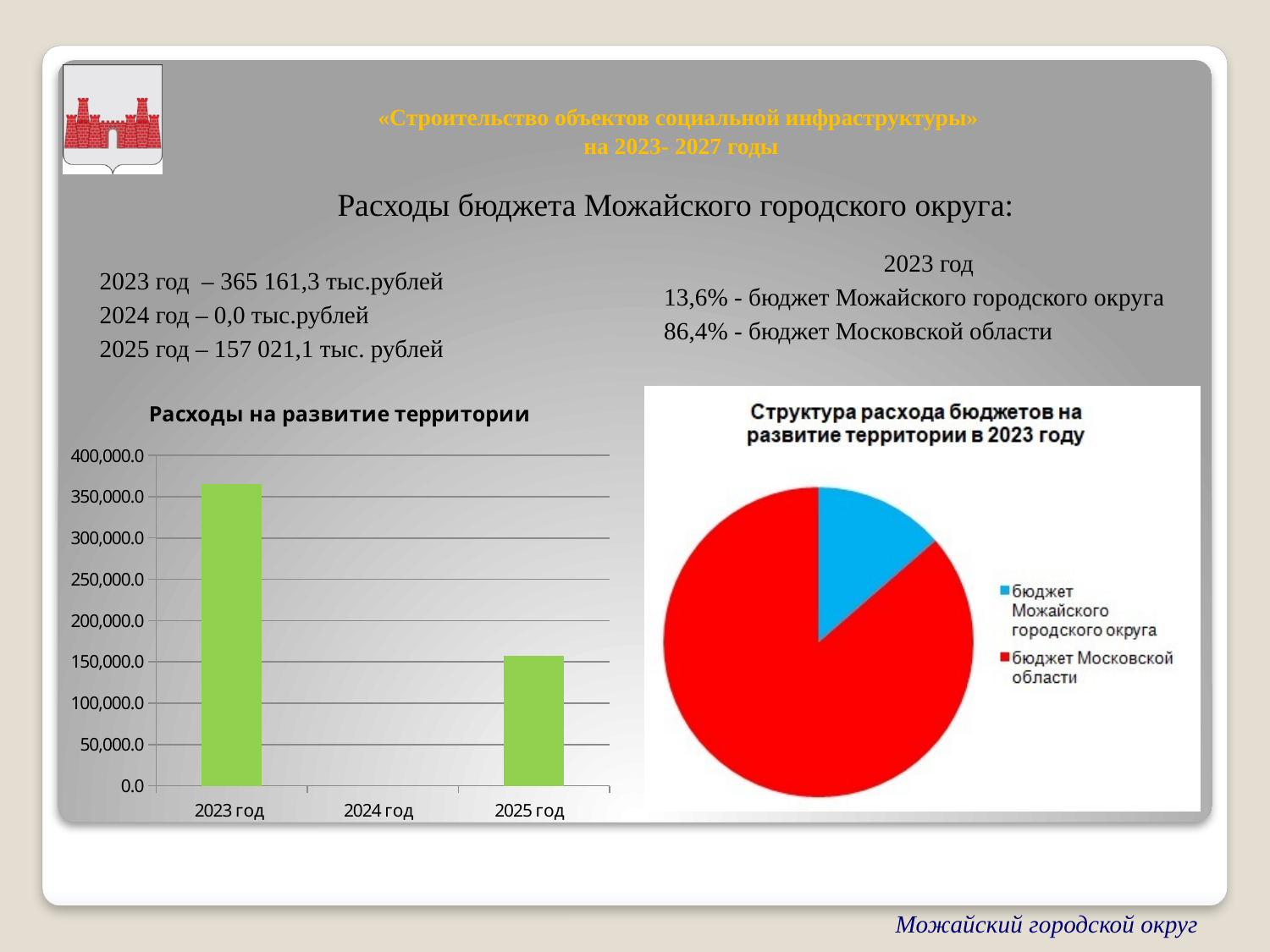
In the pie chart 'Структура расхода бюджетов на развитие территории в 2023 году', how many entries does the legend list? 2 In the 'Расходы на развитие территории' chart, is the value for 2025 год greater or less than 200,000.0? less In the 'Расходы на развитие территории' chart, how many year categories are shown on the x axis? 3 In the 'Расходы на развитие территории' chart, is the value for 2023 год greater or less than 350,000.0? greater What kind of chart is the 'Расходы на развитие территории' chart? bar chart In the 'Расходы на развитие территории' chart, which is larger, the value for 2023 год or 2025 год? 2023 год According to the slide, what are the budget expenses of the Mozhaysk urban district for 2025 год? 157 021,1 тыс. рублей What kind of chart is the 'Структура расхода бюджетов на развитие территории в 2023 году' chart? pie chart In the pie chart 'Структура расхода бюджетов на развитие территории в 2023 году', what share belongs to бюджет Московской области? 86,4% In the pie chart 'Структура расхода бюджетов на развитие территории в 2023 году', which colour represents бюджет Можайского городского округа? blue In the 'Расходы на развитие территории' chart, which year has the highest value? 2023 год In the 'Расходы на развитие территории' chart, which year has the lowest value? 2024 год